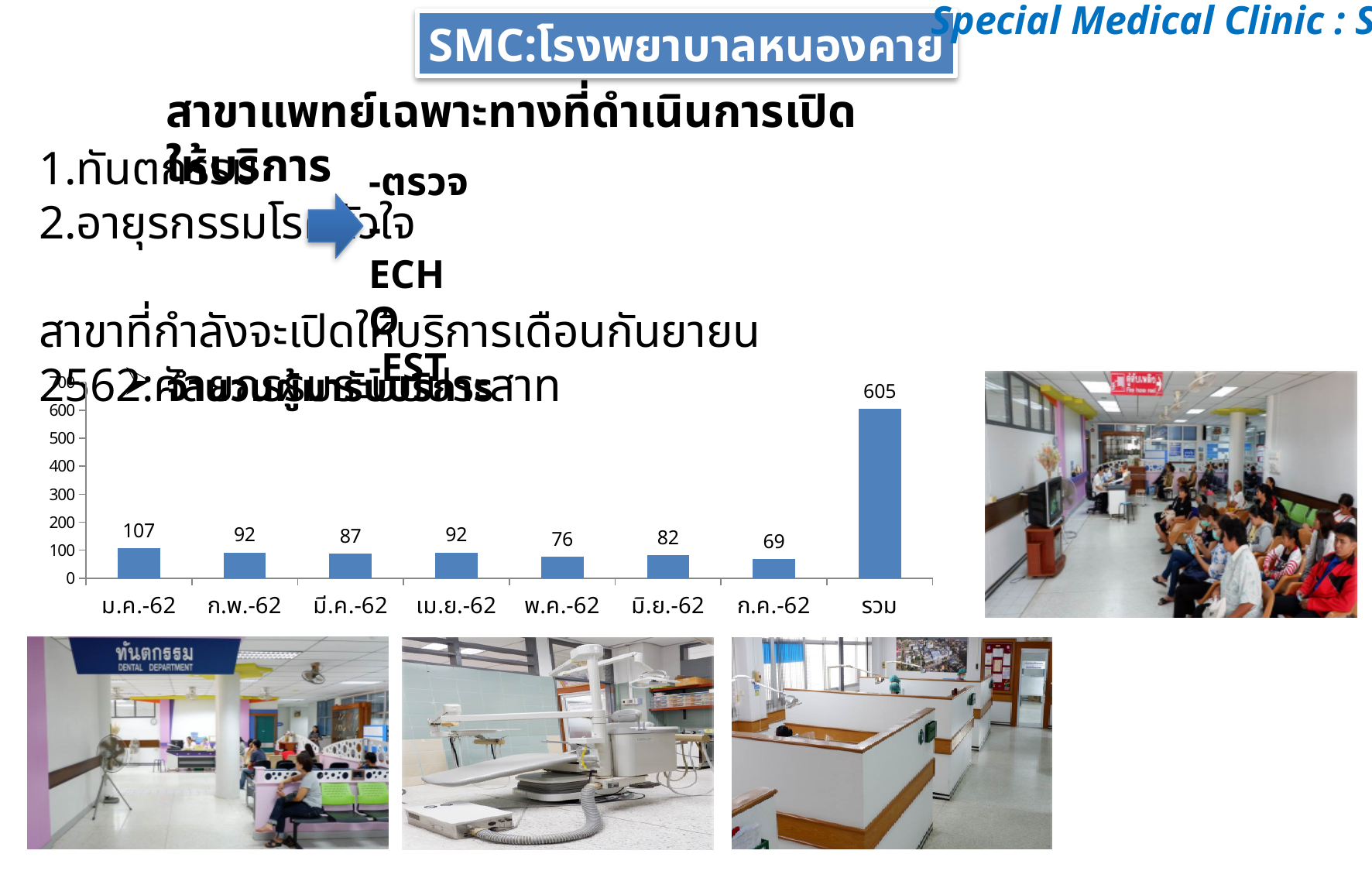
Which is larger, the value for มี.ค.-62 or the value for มิ.ย.-62? มี.ค.-62 Which month (excluding รวม) has the highest value? ม.ค.-62 What is the value for ก.ค.-62? 69 What is the difference between the values for ม.ค.-62 and ก.ค.-62? 38 What is the value for ม.ค.-62? 107 How many bars are shown in the chart? 8 Which category has the lowest value? ก.ค.-62 What kind of chart is shown on the slide? bar chart Do the values for ก.พ.-62 and เม.ย.-62 differ? No, both are 92 Is the value for รวม greater or less than 500? greater What is the value for the รวม bar? 605 What is the value for พ.ค.-62? 76